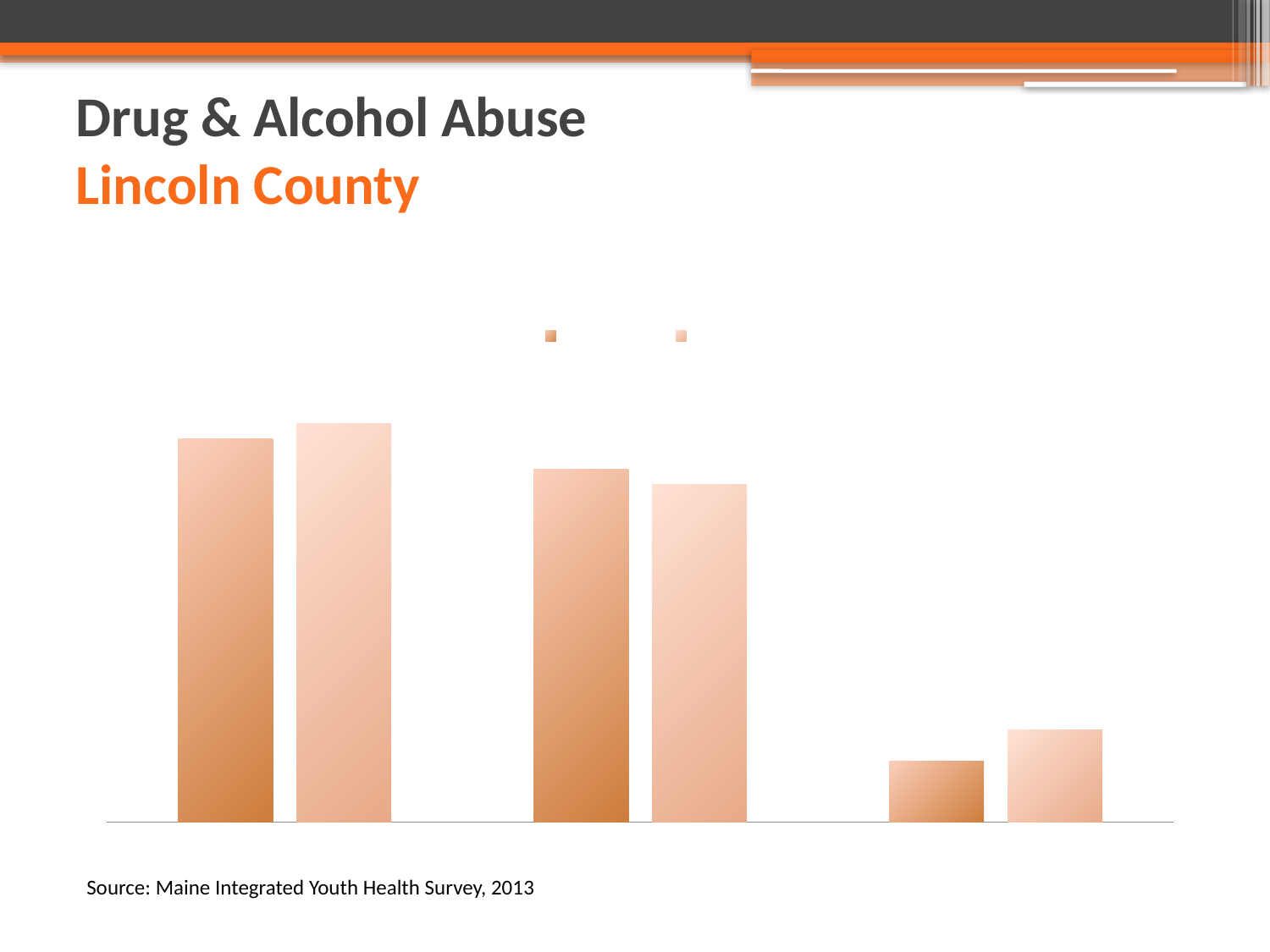
What kind of chart is shown on the slide? bar chart How many groups of bars does the chart show? 3 How many series does the legend list? 2 In the rightmost group, which bar is taller, the darker orange bar or the lighter bar? the lighter bar Which group of bars is the tallest: the leftmost, middle, or rightmost? leftmost Which group of bars is the shortest: the leftmost, middle, or rightmost? rightmost In the middle group, which bar is taller, the darker orange bar or the lighter bar? the darker orange bar What source is cited below the chart? Maine Integrated Youth Health Survey, 2013 How many bars are plotted in the chart? 6 In the leftmost group, which bar is taller, the darker orange bar or the lighter bar? the lighter bar What county is named in the slide title above the chart? Lincoln County Do the bar heights generally rise or fall from left to right across the groups? fall